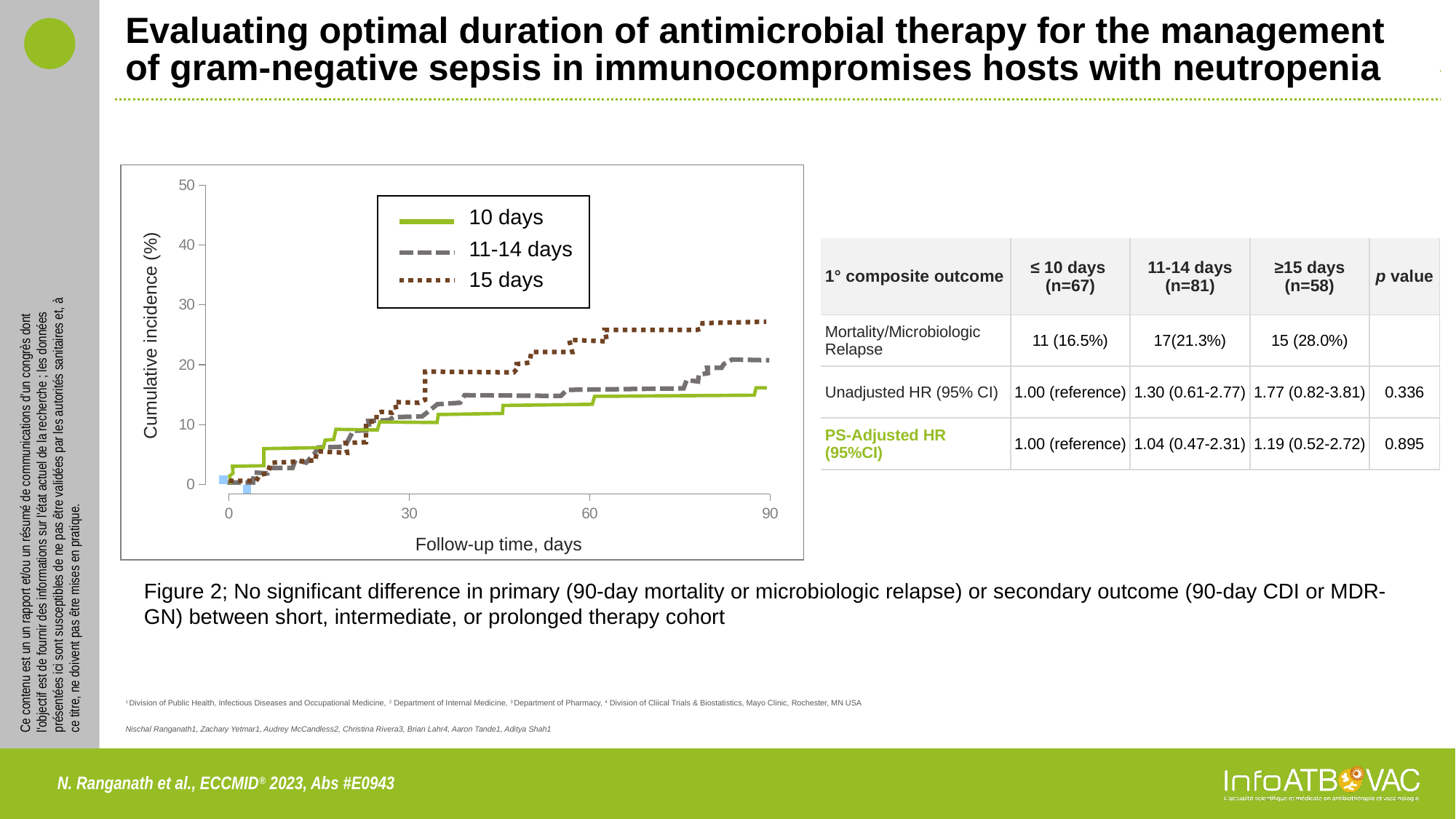
At 60 days of follow-up, which series has the larger cumulative incidence, 10 days or 15 days? 15 days What are the three series listed in the chart legend? 10 days, 11-14 days, 15 days Do the cumulative incidence curves rise or fall as follow-up time increases? Rise What kind of chart is shown on the slide? Line chart Is the cumulative incidence for the 15 days series at 60 days greater or less than 20? greater How many series does the chart legend list? 3 Which series has the lowest cumulative incidence at 90 days of follow-up? 10 days What is the label of the y axis of the chart? Cumulative incidence (%) Which series has the highest cumulative incidence at 90 days of follow-up? 15 days Is the cumulative incidence for the 15 days series at 90 days greater or less than 20? greater What is the highest value shown on the y axis of the chart? 50 Is the cumulative incidence for the 10 days series at 90 days greater or less than 20? less